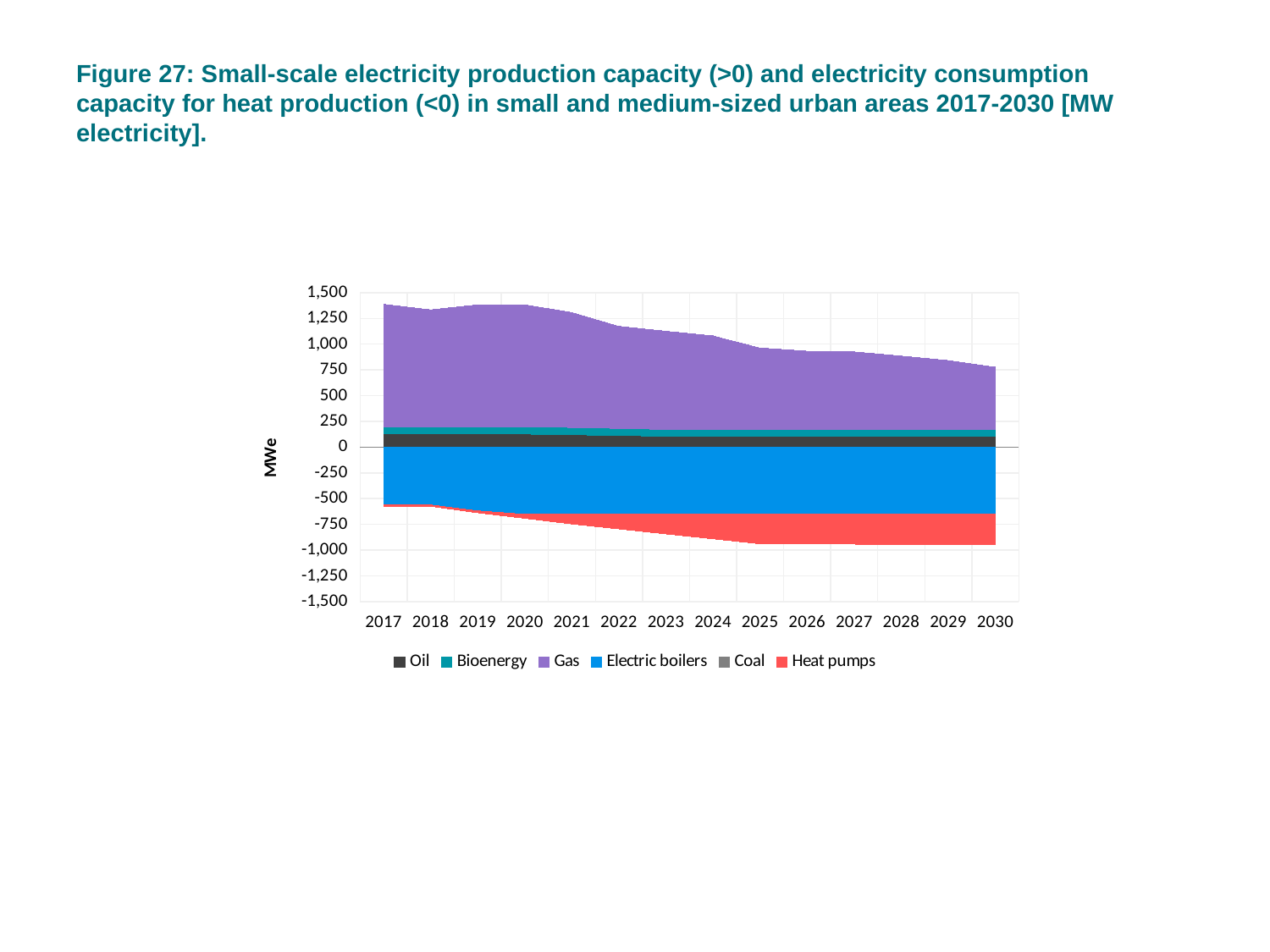
What is the last year shown on the x axis? 2030 What is the first year shown on the x axis? 2017 Which colour represents Heat pumps in the legend? Red Is the total positive production capacity in 2017 greater or less than 1,250? greater Does the total positive (production) capacity rise or fall from 2017 to 2030? Fall What is the label on the y axis? MWe How many series does the legend list? 6 Is the total positive production capacity in 2030 greater or less than 1,000? less How many years are shown along the x axis? 14 Which year has the larger total positive production capacity, 2017 or 2030? 2017 What kind of chart is shown on the slide? Stacked area chart Which series occupies the largest area above zero? Gas